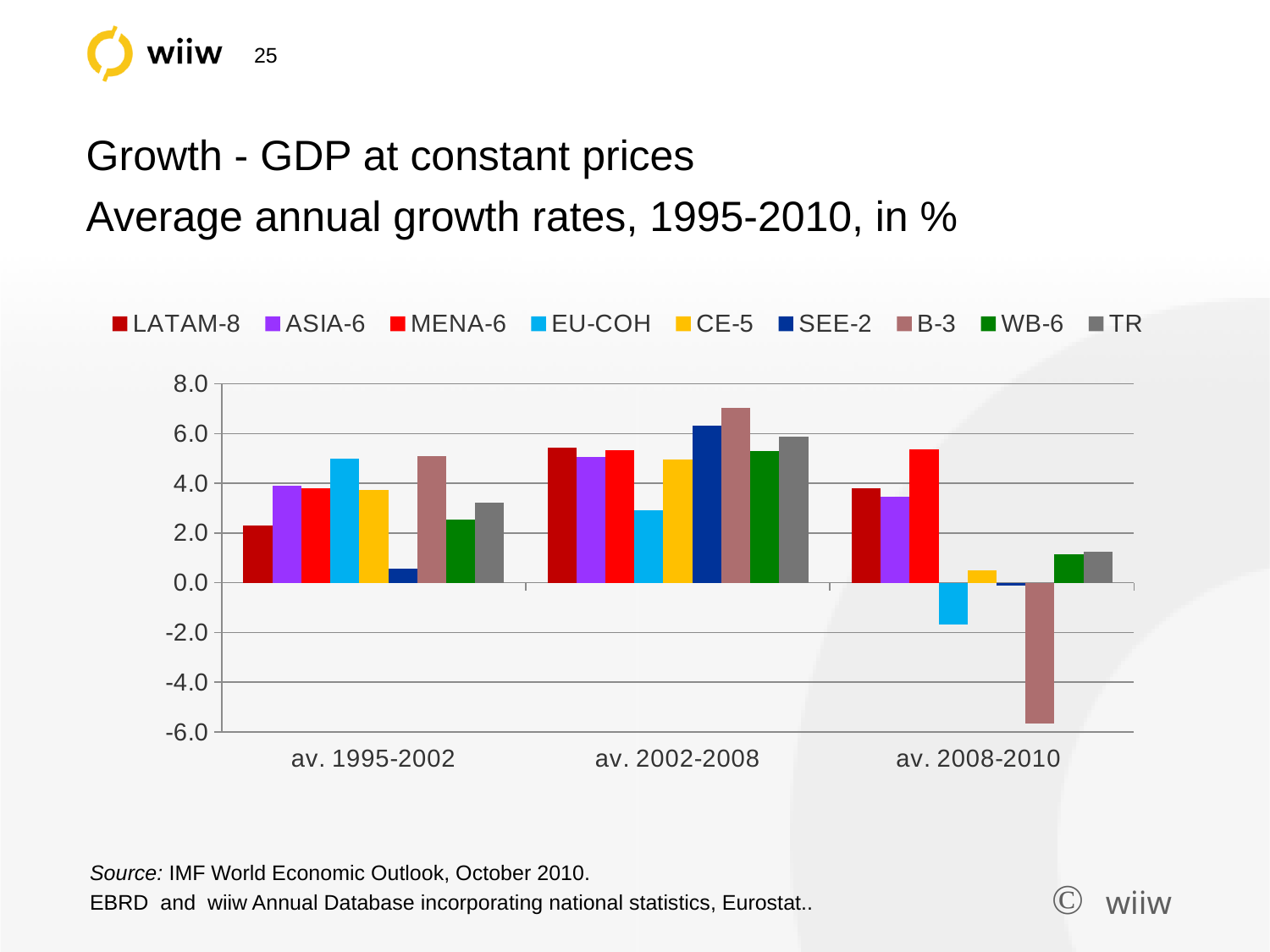
How many period categories are shown on the x axis? 3 In av. 2008-2010, which is larger: MENA-6 or EU-COH? MENA-6 Which region has the lowest average growth rate in av. 2008-2010? B-3 Is the value for EU-COH in av. 1995-2002 greater or less than 4.0? greater Which region has the highest average growth rate in av. 2002-2008? B-3 Is the value for EU-COH in av. 2008-2010 greater or less than 0.0? less Does the value for EU-COH rise or fall from av. 1995-2002 to av. 2008-2010? Falls In av. 1995-2002, which is larger: SEE-2 or B-3? B-3 What kind of chart is shown on the slide? Bar chart Which region has the lowest average growth rate in av. 1995-2002? SEE-2 How many series does the legend list? 9 Is the value for B-3 in av. 2008-2010 greater or less than -4.0? less